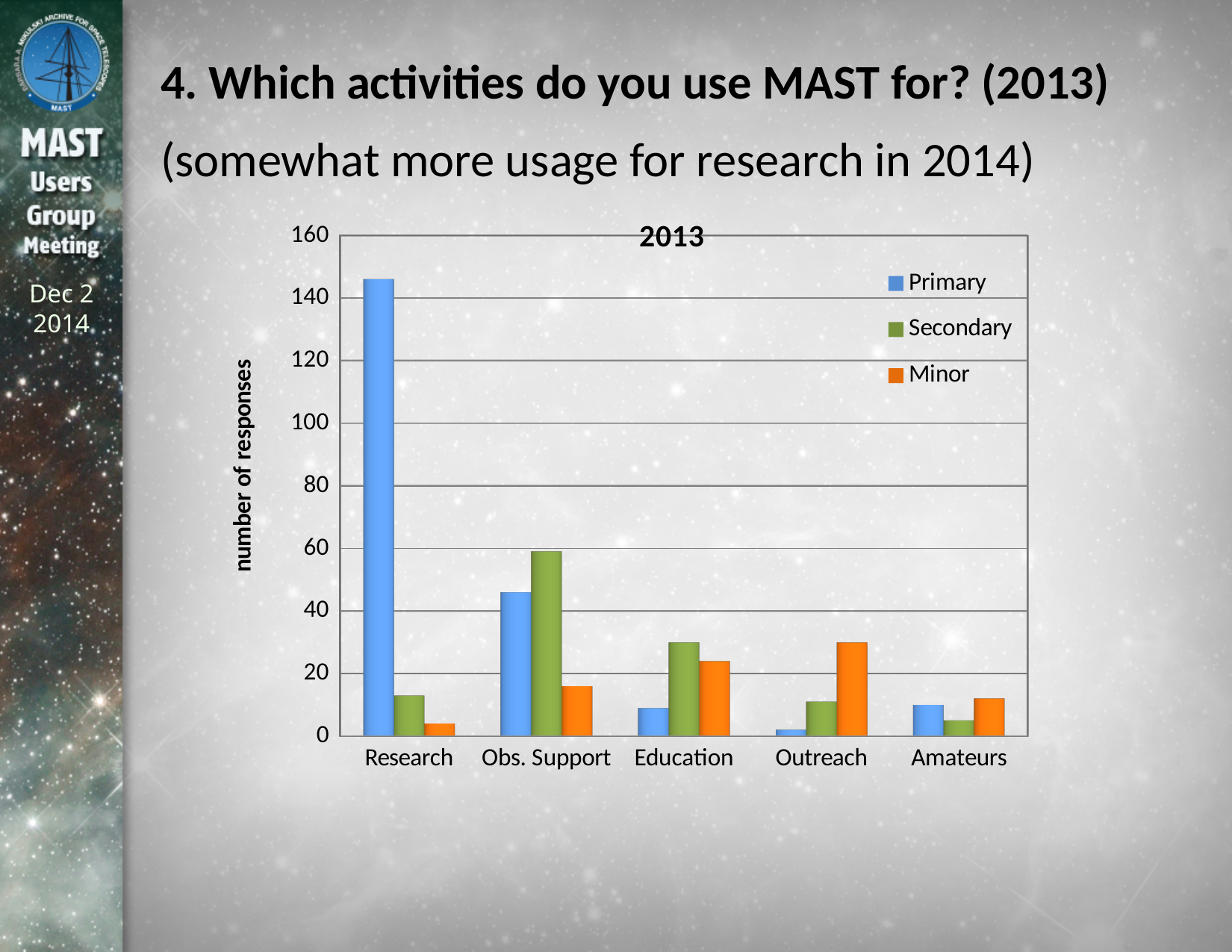
Which category has the highest Secondary value? Obs. Support For Education, which is larger: the Secondary value or the Minor value? Secondary Is the Primary value for Research greater or less than 140? greater Which category has the highest Primary value? Research Which category has the lowest Primary value? Outreach Is the Primary value for Outreach greater or less than 20? less Is the Minor value for Outreach greater or less than 20? greater How many activity categories are shown on the x axis? 5 What is the label on the vertical axis? number of responses How many series does the legend list? 3 What kind of chart is shown on the slide? bar chart